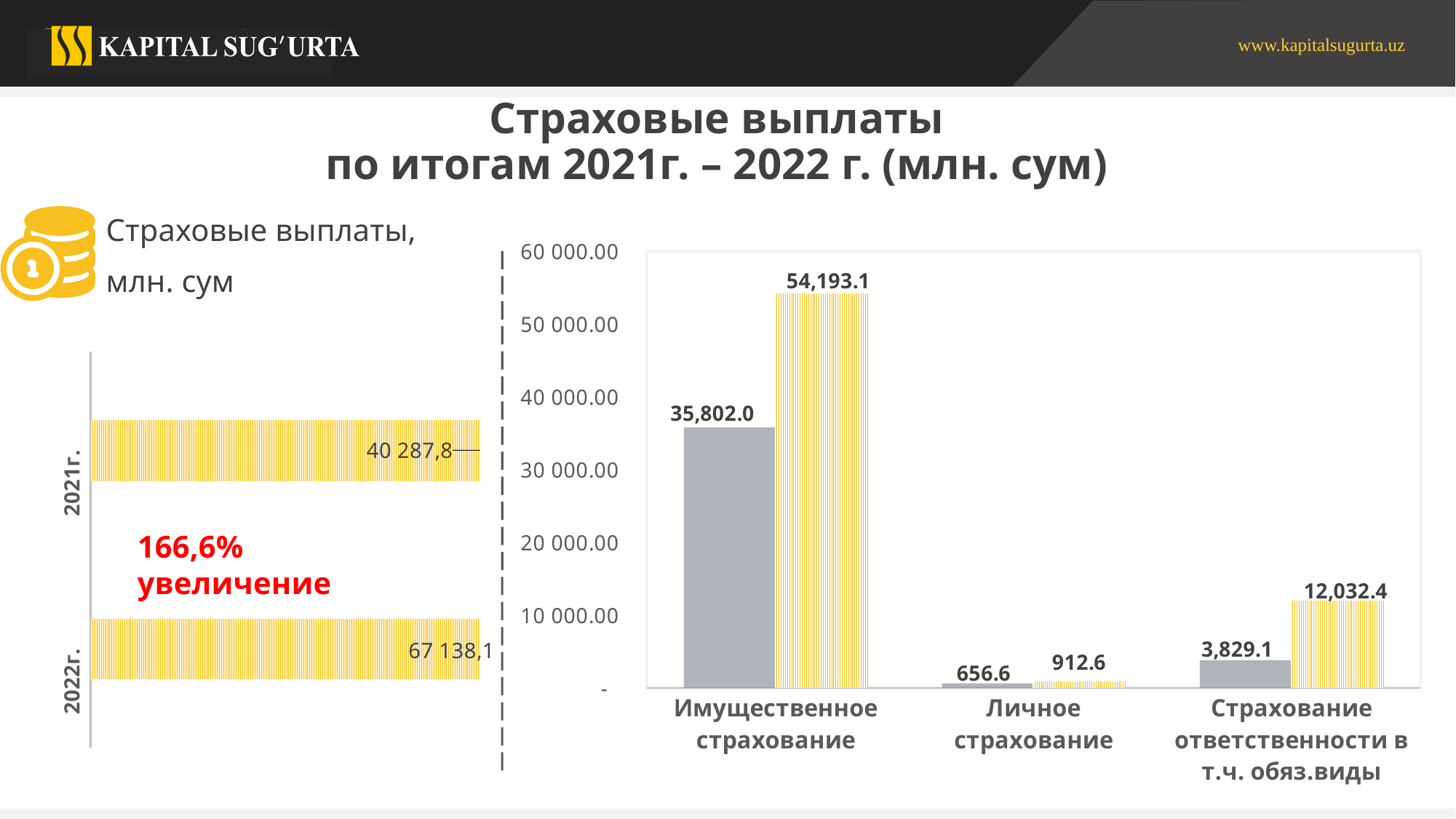
In the left chart (Страховые выплаты, млн. сум), what percentage increase is stated in red text? 166,6% увеличение In the right chart, what is the value of the yellow striped bar for Личное страхование? 912.6 In the left chart (Страховые выплаты, млн. сум), what is the value for 2022г.? 67 138,1 In the right chart, what is the value of the grey bar for Страхование ответственности в т.ч. обяз.виды? 3,829.1 What type of chart is the left chart (Страховые выплаты, млн. сум)? Bar chart In the right chart, what is the value of the grey bar for Имущественное страхование? 35,802.0 In the left chart (Страховые выплаты, млн. сум), which year has the higher value? 2022г. In the right chart, is the yellow striped bar for Страхование ответственности в т.ч. обяз.виды greater or less than 10 000.00? greater In the left chart (Страховые выплаты, млн. сум), what is the value for 2021г.? 40 287,8 In the right chart, how many categories are shown on the x axis? 3 In the right chart, which category has the lowest grey bar value? Личное страхование In the right chart, what is the value of the yellow striped bar for Имущественное страхование? 54,193.1